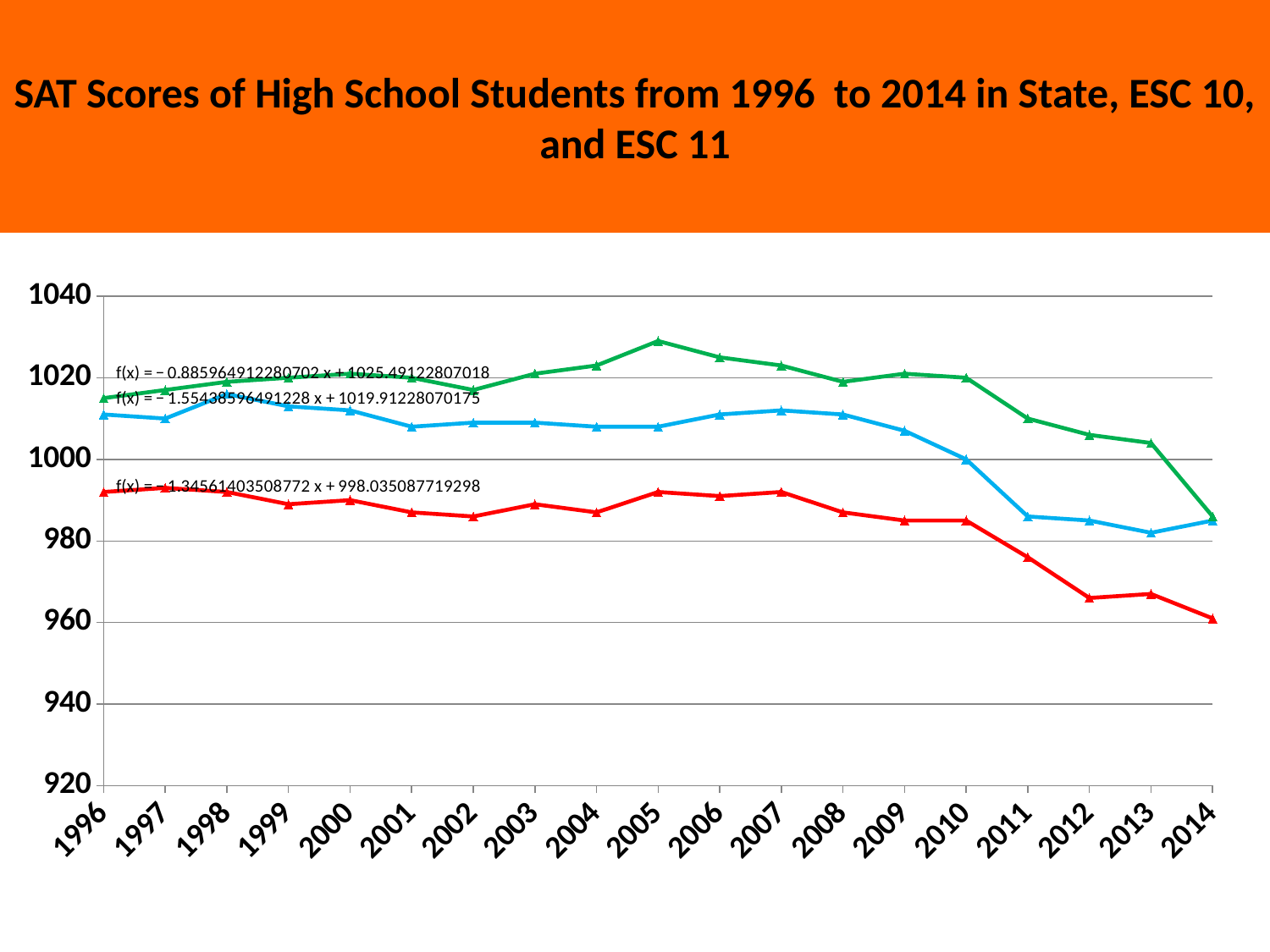
Is the value of the red line in 1996 greater or less than 1000? less In which year does the green line reach its highest value? 2005 In 2000, which line has the larger value, the blue line or the red line? blue line What is the title of the slide's chart? SAT Scores of High School Students from 1996 to 2014 in State, ESC 10, and ESC 11 In which year does the red line reach its lowest value? 2014 What kind of chart is shown on the slide? line chart How many trend line equations are printed on the chart? 3 In which year does the green line reach its lowest value? 2014 In 2005, which line has the larger value, the green line or the red line? green line How many years are shown along the x axis of the chart? 19 Overall, do the plotted lines rise or fall from 1996 to 2014? fall Is the value of the green line in 2005 greater or less than 1020? greater